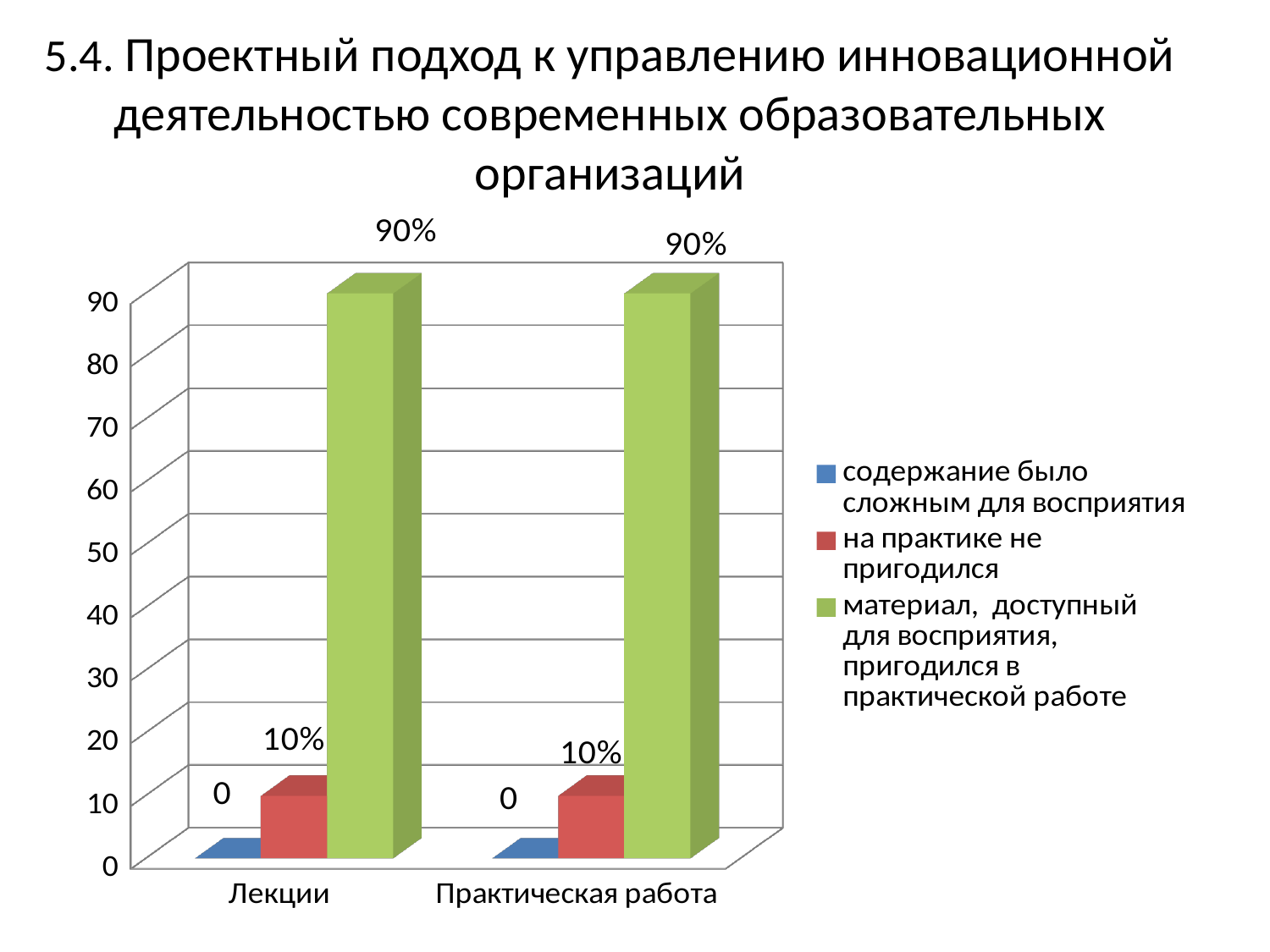
Which series has the lowest value in the "Практическая работа" category? содержание было сложным для восприятия What is the difference between the values for "материал, доступный для восприятия, пригодился в практической работе" and "на практике не пригодился" in the "Лекции" category? 80% What colour are the bars for the series "на практике не пригодился"? red What is the value for "на практике не пригодился" in the "Практическая работа" category? 10% How many categories are shown on the x axis of the chart? 2 Which series has the highest value in the "Лекции" category? материал, доступный для восприятия, пригодился в практической работе What is the value for "содержание было сложным для восприятия" in the "Лекции" category? 0 Which is larger in the "Практическая работа" category: "на практике не пригодился" or "содержание было сложным для восприятия"? на практике не пригодился What is the value for "материал, доступный для восприятия, пригодился в практической работе" in the "Лекции" category? 90% How many series does the chart's legend list? 3 What kind of chart is shown on the slide? bar chart What is the value for "материал, доступный для восприятия, пригодился в практической работе" in the "Практическая работа" category? 90%